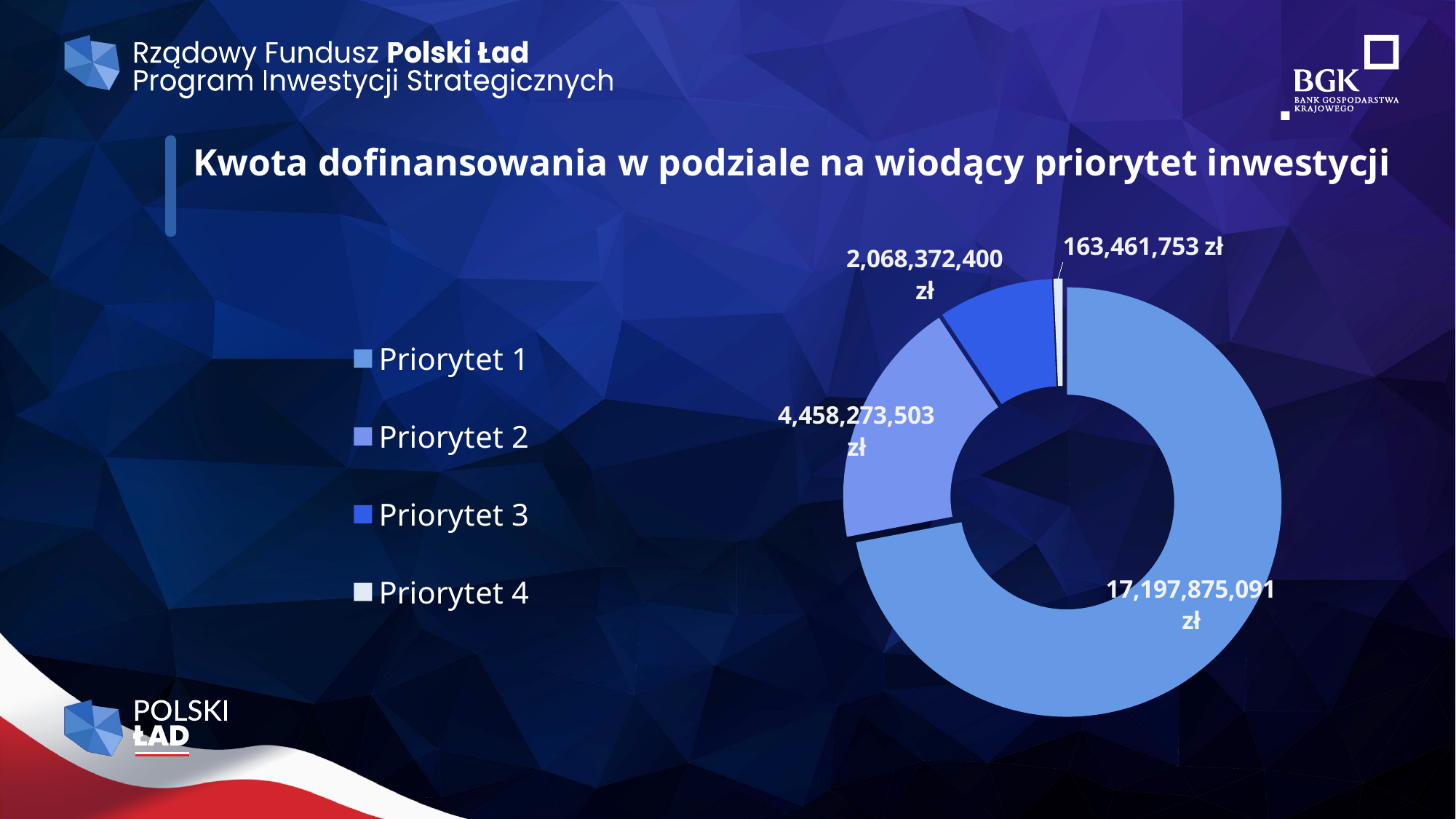
What is the title of the chart? Kwota dofinansowania w podziale na wiodący priorytet inwestycji What is the value for Priorytet 4? 163,461,753 zł Which is larger, the value for Priorytet 2 or the value for Priorytet 3? Priorytet 2 What is the value for Priorytet 1? 17,197,875,091 zł How many categories does the chart show? 4 Which priority has the lowest funding amount? Priorytet 4 What is the value for Priorytet 2? 4,458,273,503 zł What is the difference between the values for Priorytet 3 and Priorytet 4? 1,904,910,647 zł What is the value for Priorytet 3? 2,068,372,400 zł What is the difference between the values for Priorytet 1 and Priorytet 2? 12,739,601,588 zł What kind of chart is shown on the slide? Pie (donut) chart Which priority has the highest funding amount? Priorytet 1